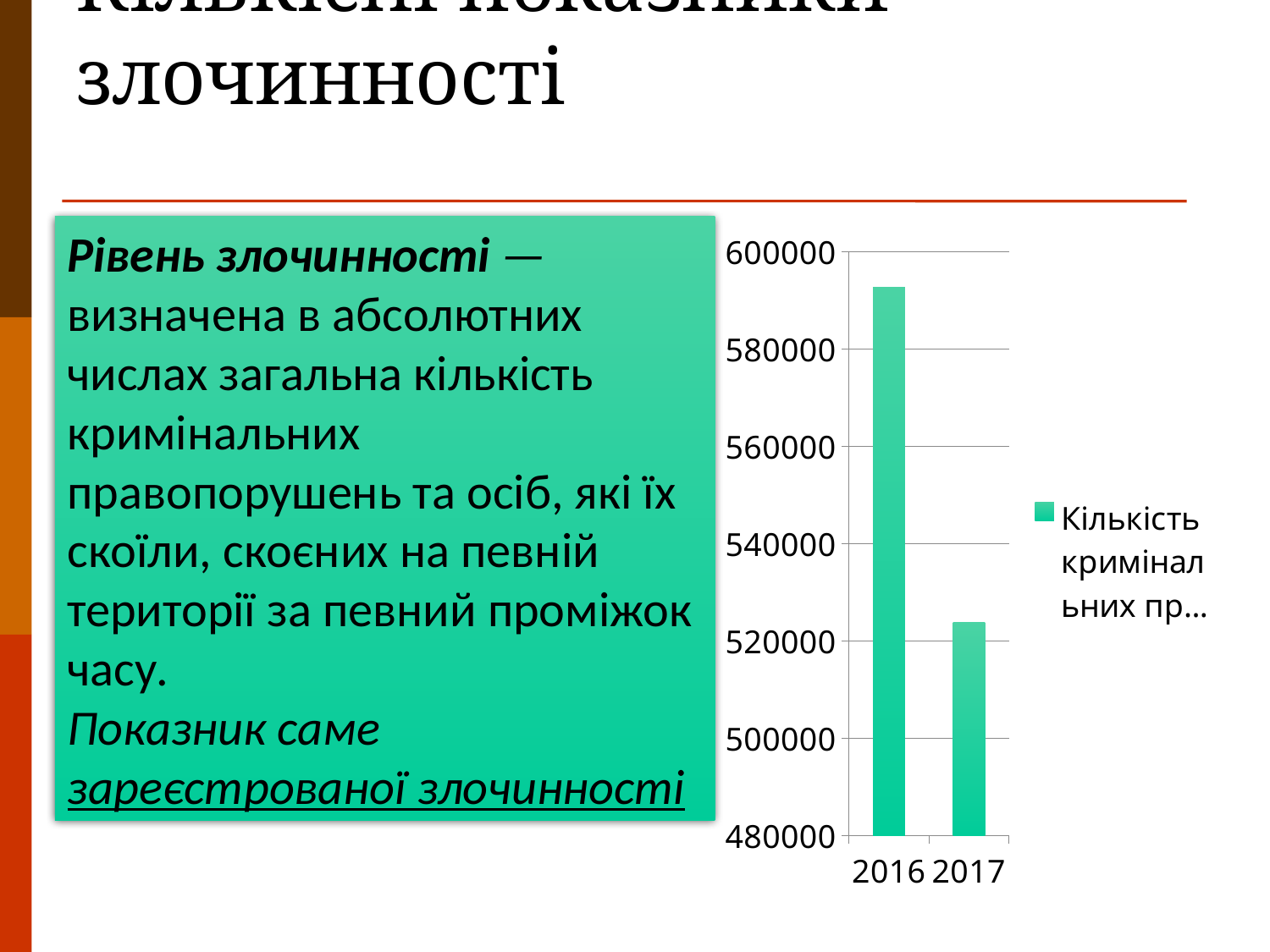
Which is larger, the value for 2016 or the value for 2017? 2016 Is the value for 2016 greater or less than 580000? greater Which year has the highest bar in the chart? 2016 What kind of chart is shown on the slide? bar chart Which year has the lowest bar in the chart? 2017 What is the lowest value shown on the chart's vertical axis? 480000 Is the value for 2017 greater or less than 500000? greater How many series does the chart's legend list? 1 Is the value for 2017 greater or less than 540000? less Do the values rise or fall from 2016 to 2017? fall What is the highest value shown on the chart's vertical axis? 600000 How many categories are shown on the x axis of the chart? 2